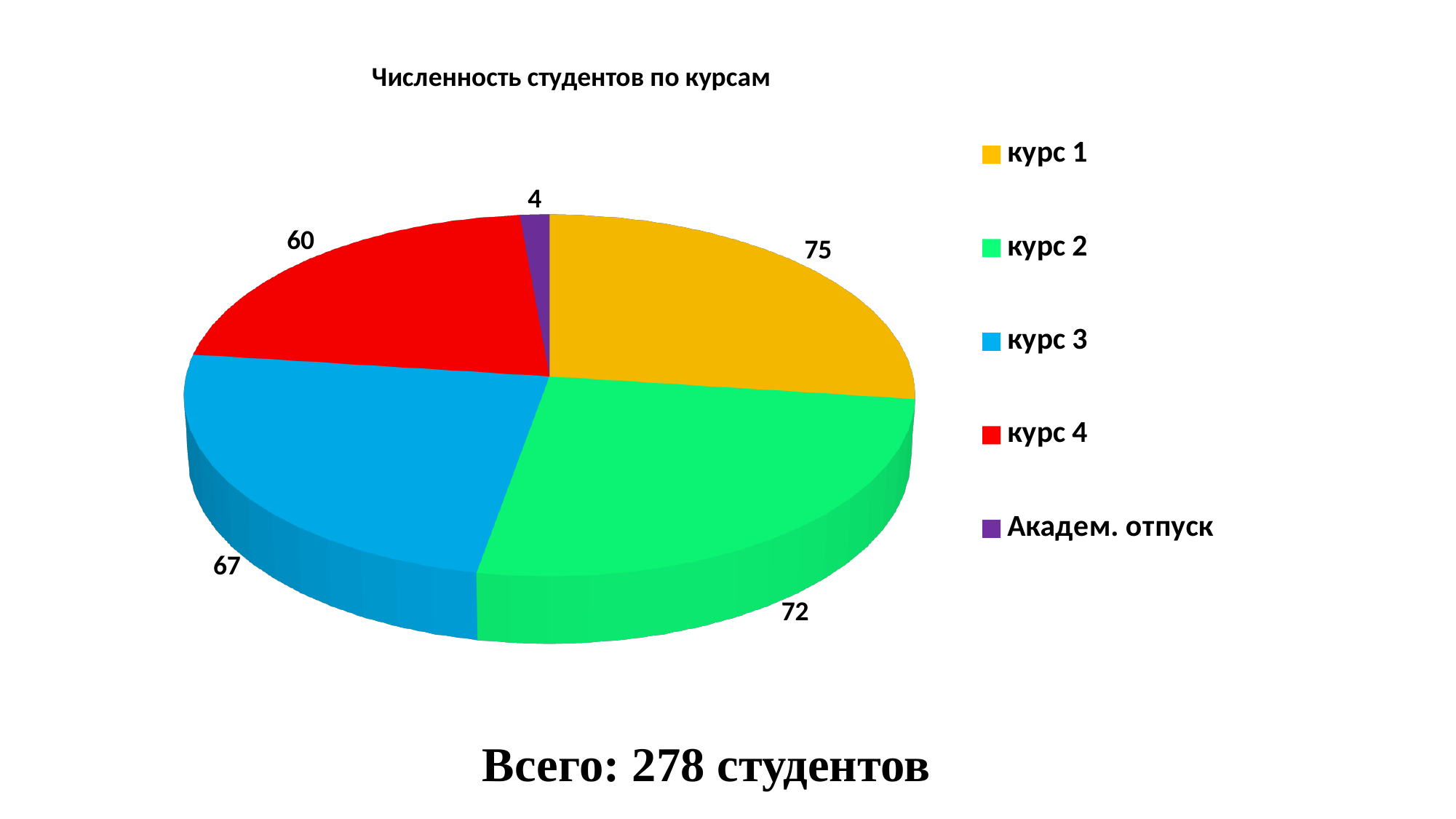
What is the total number of students shown on the slide? 278 What is the title of the chart? Численность студентов по курсам What is the difference between the number of students in курс 1 and курс 4? 15 How many categories does the legend list? 5 Which is larger, the value for курс 2 or the value for курс 3? курс 2 What value is shown for Академ. отпуск? 4 Which category has the largest slice of the pie? курс 1 What kind of chart is shown on the slide? Pie chart How many students are in курс 1? 75 What share of the total 278 students does курс 1 represent, to the nearest whole percent? 27% Which category has the smallest slice of the pie? Академ. отпуск How many students are in курс 3? 67